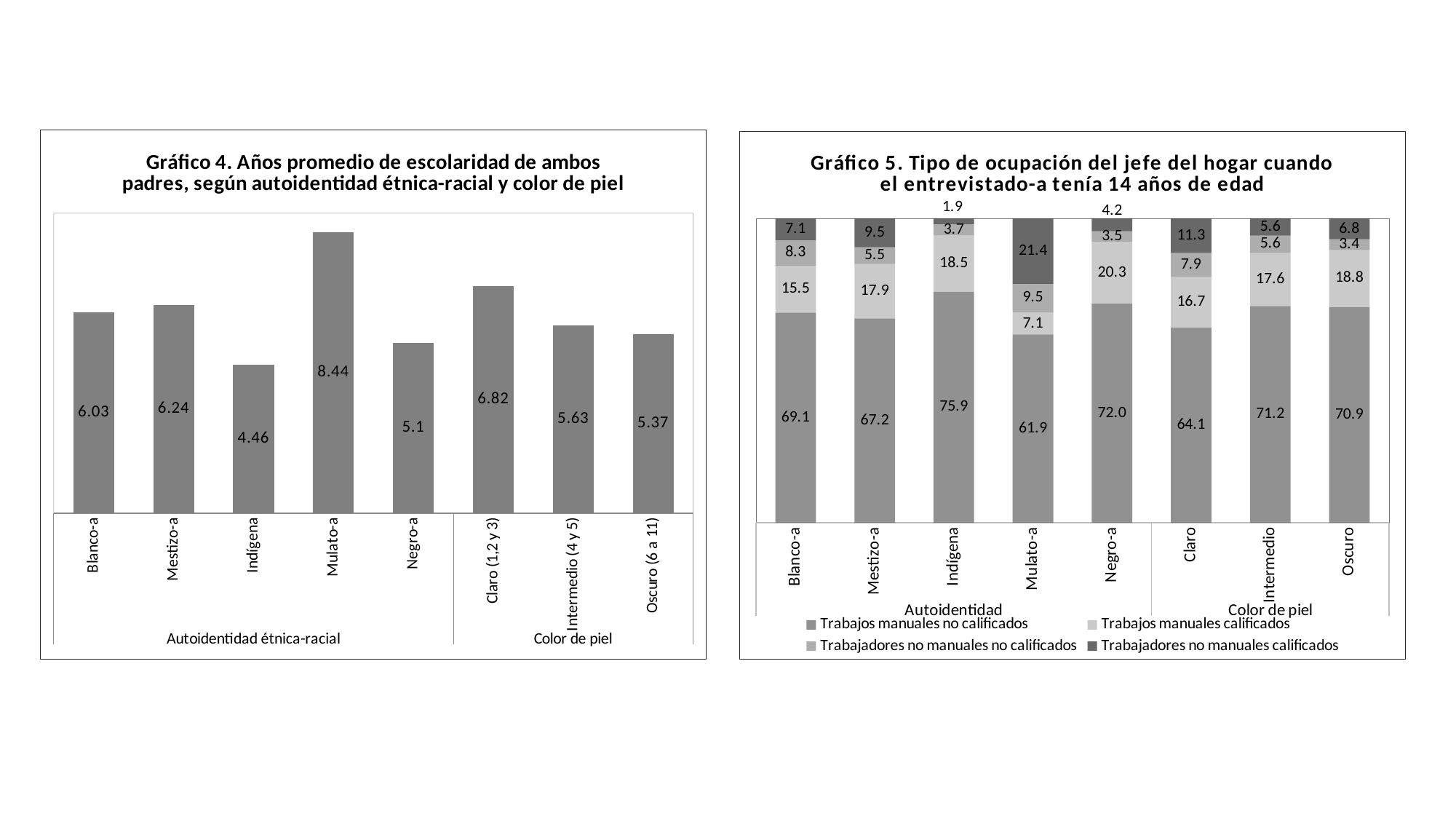
In Gráfico 4, what is the difference between the values for Claro (1,2 y 3) and Oscuro (6 a 11)? 1.45 What kind of chart is Gráfico 4? Bar chart In Gráfico 4, which category has the highest value? Mulato-a In Gráfico 4, how many bars are plotted? 8 In Gráfico 4, which category has the lowest value? Indígena In Gráfico 5, what is the value of Trabajos manuales no calificados for Indígena? 75.9 In Gráfico 4, what is the average years of schooling for Mulato-a? 8.44 In Gráfico 4, which is larger, the value for Blanco-a or the value for Mestizo-a? Mestizo-a In Gráfico 5, what is the value of Trabajadores no manuales calificados for Mulato-a? 21.4 In Gráfico 5, which category has the lowest value for Trabajos manuales no calificados? Mulato-a In Gráfico 5, how many series does the legend list? 4 In Gráfico 5, what is the difference between the Trabajos manuales calificados values for Negro-a and Claro? 3.6